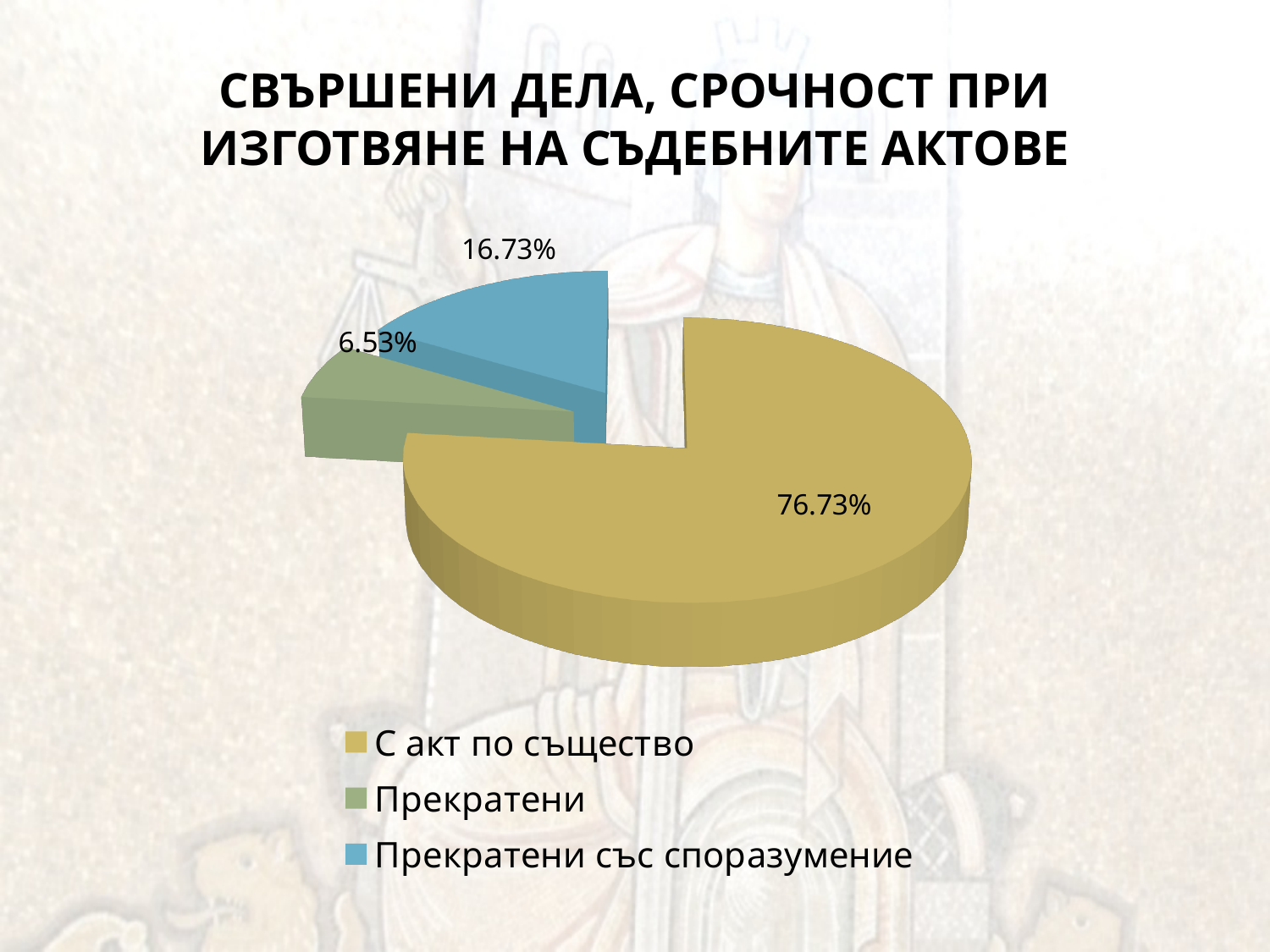
How many entries does the legend list? 3 Which is larger: the slice for "Прекратени" or the slice for "Прекратени със споразумение"? Прекратени със споразумение What share of the pie is labelled for "Прекратени със споразумение"? 16.73% Which category has the smallest slice of the pie? Прекратени What is the difference in percentage points between "С акт по същество" and "Прекратени със споразумение"? 60.00 What share of the pie is labelled for "С акт по същество"? 76.73% What share of the pie is labelled for "Прекратени"? 6.53% What colour is the slice for "Прекратени със споразумение"? blue How many slices does the pie chart have? 3 What is the difference in percentage points between "Прекратени със споразумение" and "Прекратени"? 10.20 Which category has the largest slice of the pie? С акт по същество What kind of chart is shown on the slide? pie chart